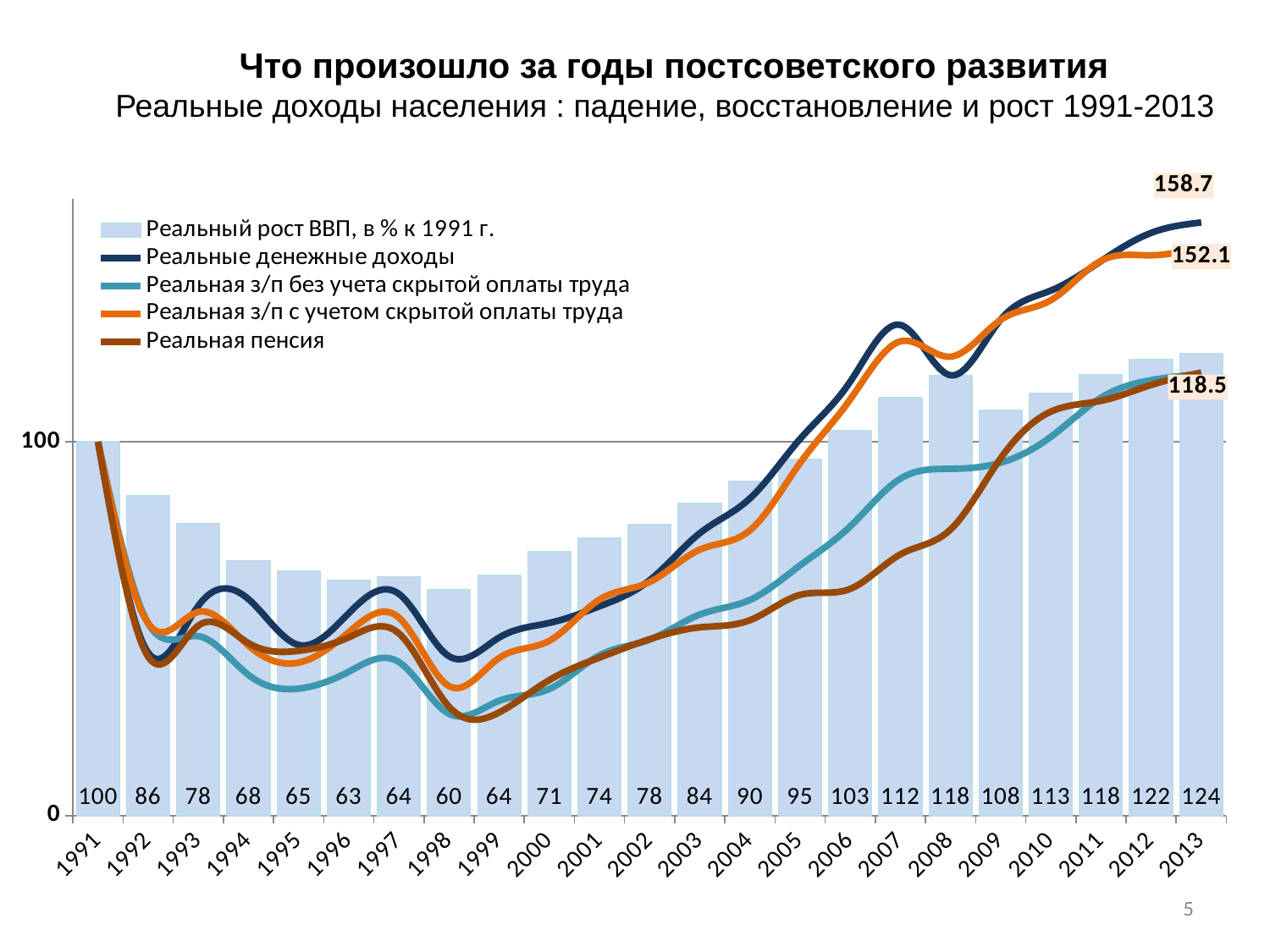
How many years are shown on the x axis? 23 Which year has the larger real GDP growth value, 2008 or 2009? 2008 How many series does the legend list? 5 In which year is the real GDP growth bar lowest? 1998 What is the final labelled value of the real pension line (Реальная пенсия)? 118.5 What is the value of the real GDP growth bar (Реальный рост ВВП) for 1998? 60 What is the final labelled value of the real money incomes line (Реальные денежные доходы)? 158.7 In which year is the real GDP growth bar highest? 2013 What is the final labelled value of the real wages including hidden pay line (Реальная з/п с учетом скрытой оплаты труда)? 152.1 What is the difference between the real GDP growth values for 2013 and 1991? 24 What is the value of the real GDP growth bar for 2013? 124 Is the value of the real wages without hidden pay line (Реальная з/п без учета скрытой оплаты труда) in 2005 greater or less than 100? less